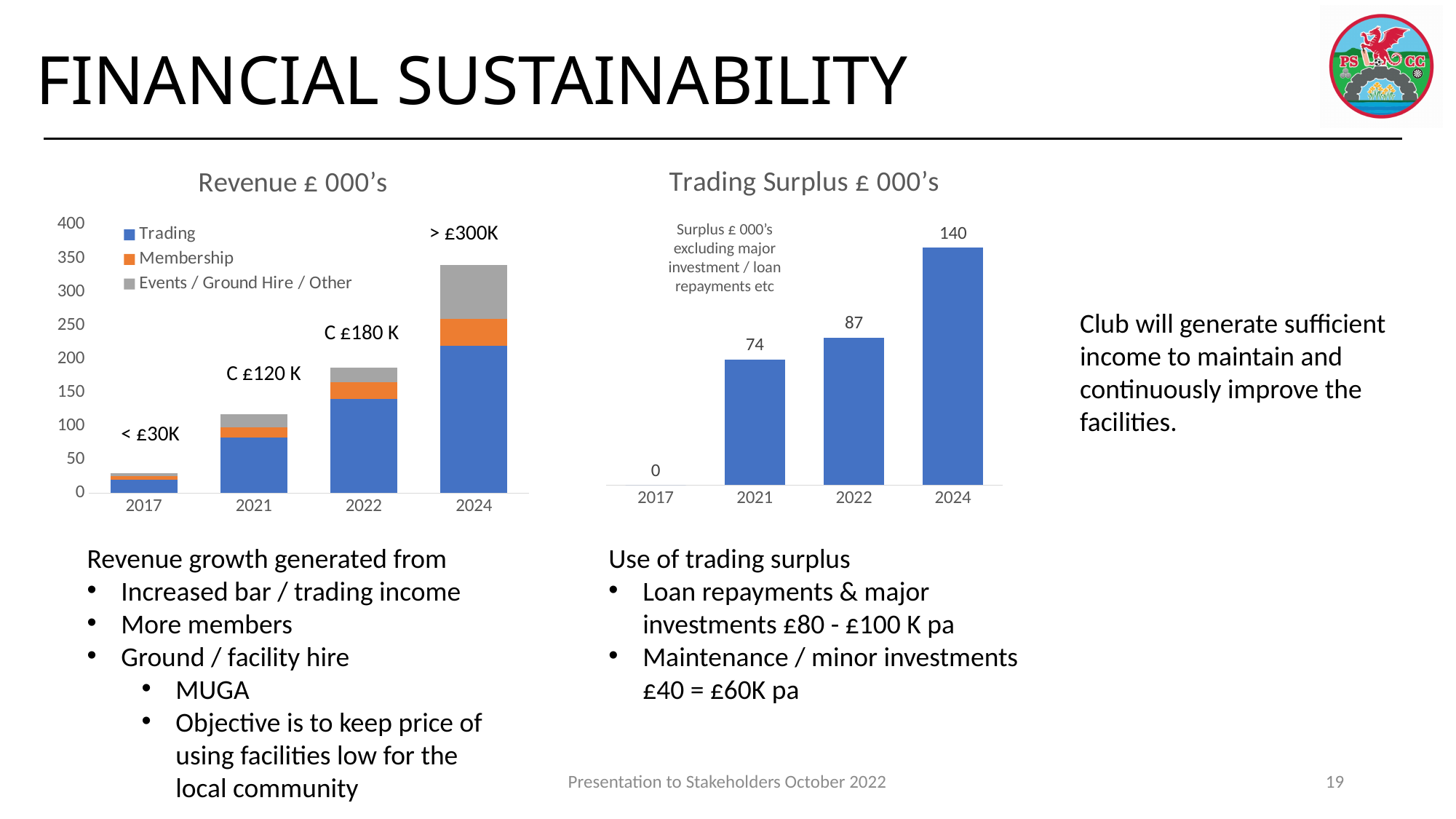
In the Revenue £ 000's chart, which year has the lowest total revenue? 2017 In the Trading Surplus £ 000's chart, which year has the highest value? 2024 In the Trading Surplus £ 000's chart, which is larger, the value for 2021 or 2022? 2022 In the Trading Surplus £ 000's chart, what is the difference between the 2024 and 2022 values? 53 In the Trading Surplus £ 000's chart, do the values rise or fall from 2017 to 2024? rise In the Revenue £ 000's chart, is the Trading value for 2024 greater or less than 200? greater What kind of chart is the Revenue £ 000's chart? stacked bar chart In the Trading Surplus £ 000's chart, what is the value for 2017? 0 In the Trading Surplus £ 000's chart, what is the value for 2024? 140 In the Revenue £ 000's chart, how many years are shown on the x axis? 4 In the Revenue £ 000's chart, how many series does the legend list? 3 In the Trading Surplus £ 000's chart, what is the value for 2021? 74